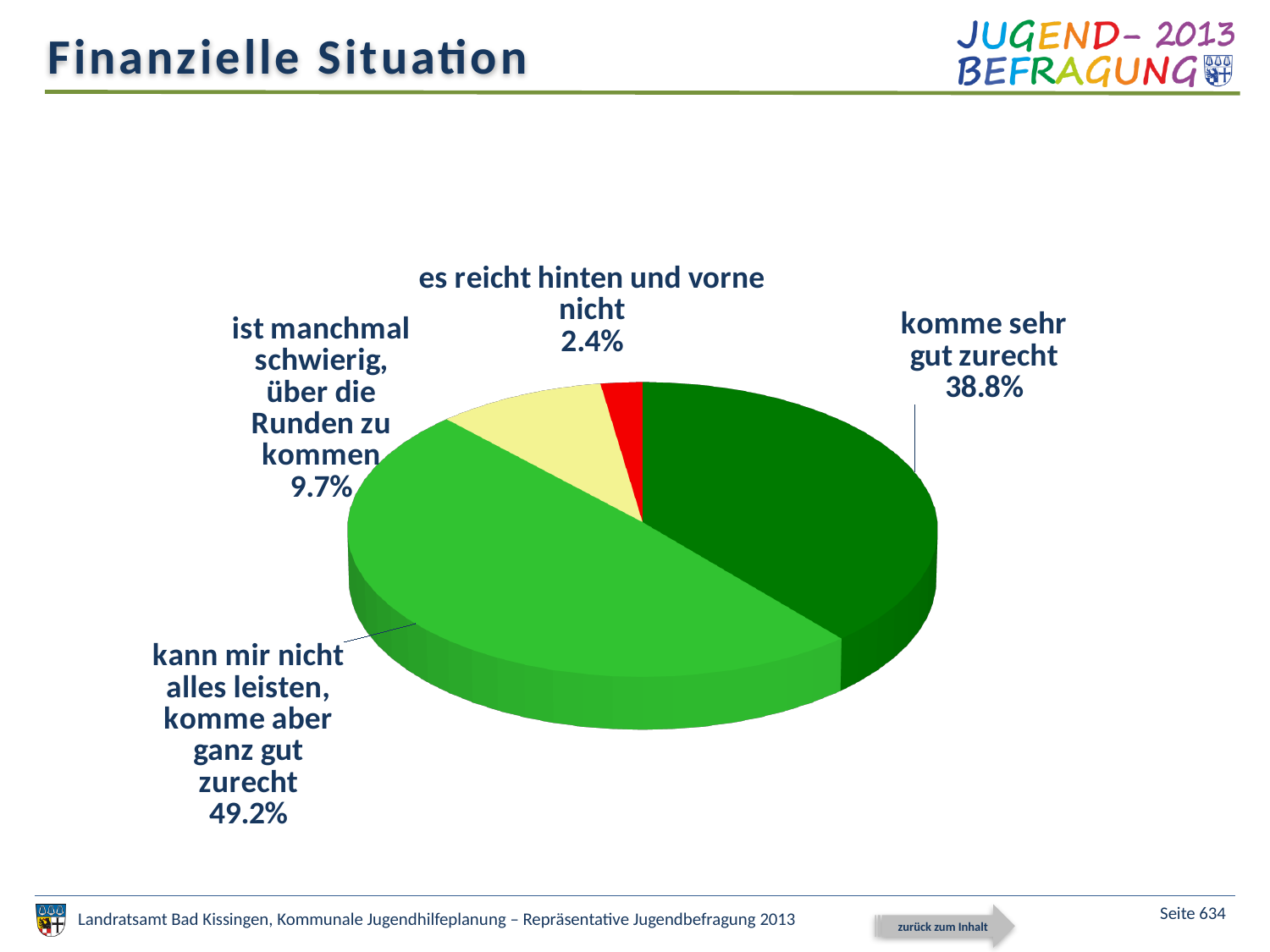
Which category has the largest slice of the pie? kann mir nicht alles leisten, komme aber ganz gut zurecht What is the difference in percentage points between "kann mir nicht alles leisten, komme aber ganz gut zurecht" and "komme sehr gut zurecht"? 10.4 Which category has the smallest slice of the pie? es reicht hinten und vorne nicht Which is larger: the share for "ist manchmal schwierig, über die Runden zu kommen" or for "es reicht hinten und vorne nicht"? ist manchmal schwierig, über die Runden zu kommen What share of respondents answered "es reicht hinten und vorne nicht"? 2.4% How many categories are shown in the pie chart? 4 What share of respondents answered "kann mir nicht alles leisten, komme aber ganz gut zurecht"? 49.2% What type of chart is shown on the slide? pie chart What share of respondents answered "komme sehr gut zurecht"? 38.8% What is the title of the slide containing the chart? Finanzielle Situation What colour is the slice for "es reicht hinten und vorne nicht"? red What share of respondents answered "ist manchmal schwierig, über die Runden zu kommen"? 9.7%